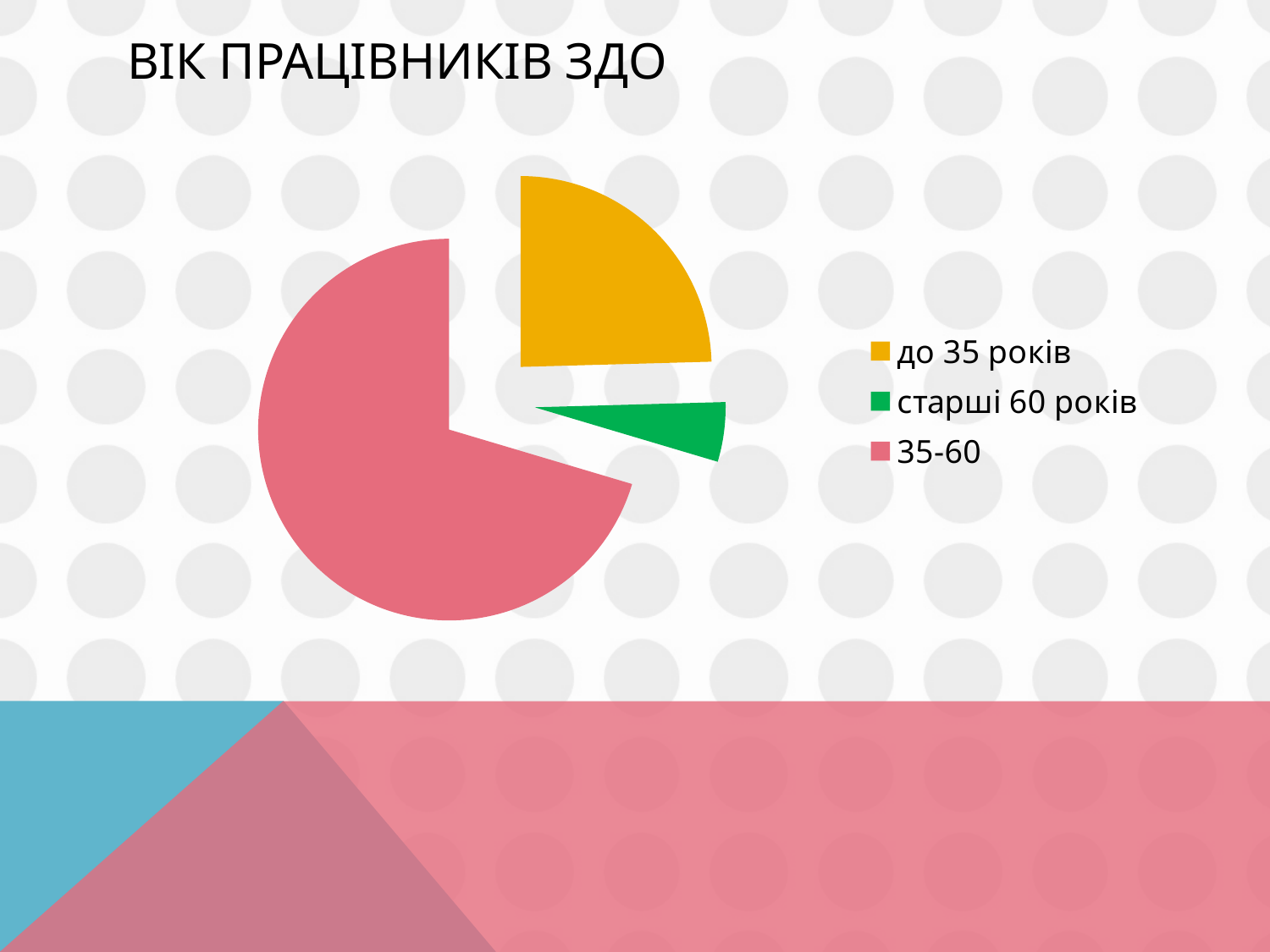
How many slices does the pie chart have? 3 What is the title of the chart? ВІК ПРАЦІВНИКІВ ЗДО Which slice is larger: "до 35 років" or "старші 60 років"? до 35 років Which category has the smallest slice of the pie? старші 60 років Is the share of the "старші 60 років" slice greater or less than a quarter of the pie? less What kind of chart is shown on the slide? pie chart What colour is the slice for "до 35 років"? yellow Is the share of the "35-60" slice greater or less than half of the pie? greater Which category has the largest slice of the pie? 35-60 How many entries does the legend list? 3 Which slice is larger: "35-60" or "до 35 років"? 35-60